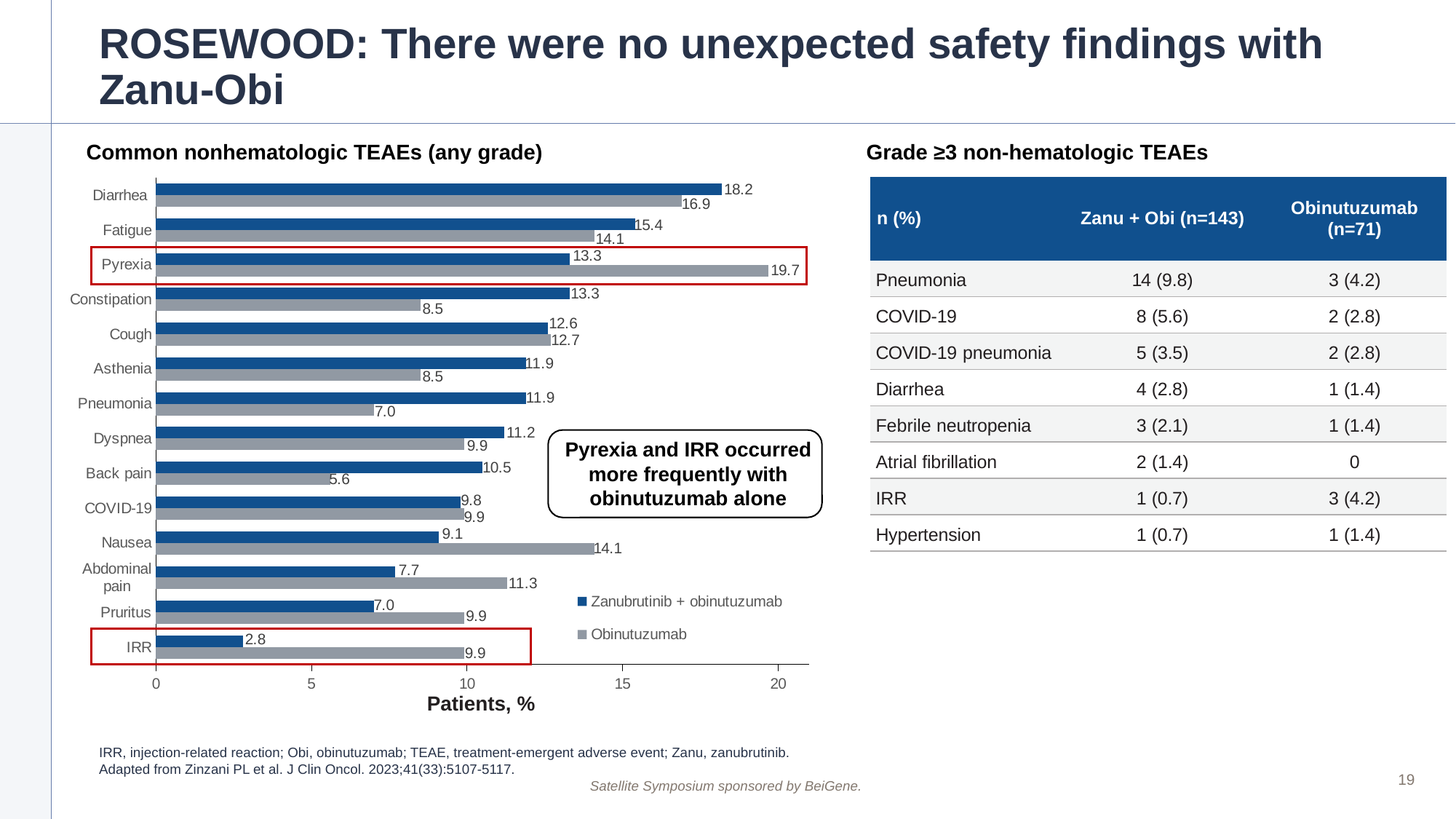
What is the title of the chart? Common nonhematologic TEAEs (any grade) What is the value for Back pain in the Zanubrutinib + obinutuzumab series? 10.5 What is the difference between the Obinutuzumab and Zanubrutinib + obinutuzumab values for IRR? 7.1 Which category has the lowest value in the Obinutuzumab series? Back pain Which category has the highest value in the Zanubrutinib + obinutuzumab series? Diarrhea What is the value for Pyrexia in the Obinutuzumab series? 19.7 What kind of chart is shown on the slide? Bar chart How many series does the chart legend list? 2 How many categories (adverse events) are shown on the chart? 14 For Nausea, which series has the larger value? Obinutuzumab What is the x-axis label of the chart? Patients, % Is the value for Pneumonia in the Obinutuzumab series greater or less than 10? less